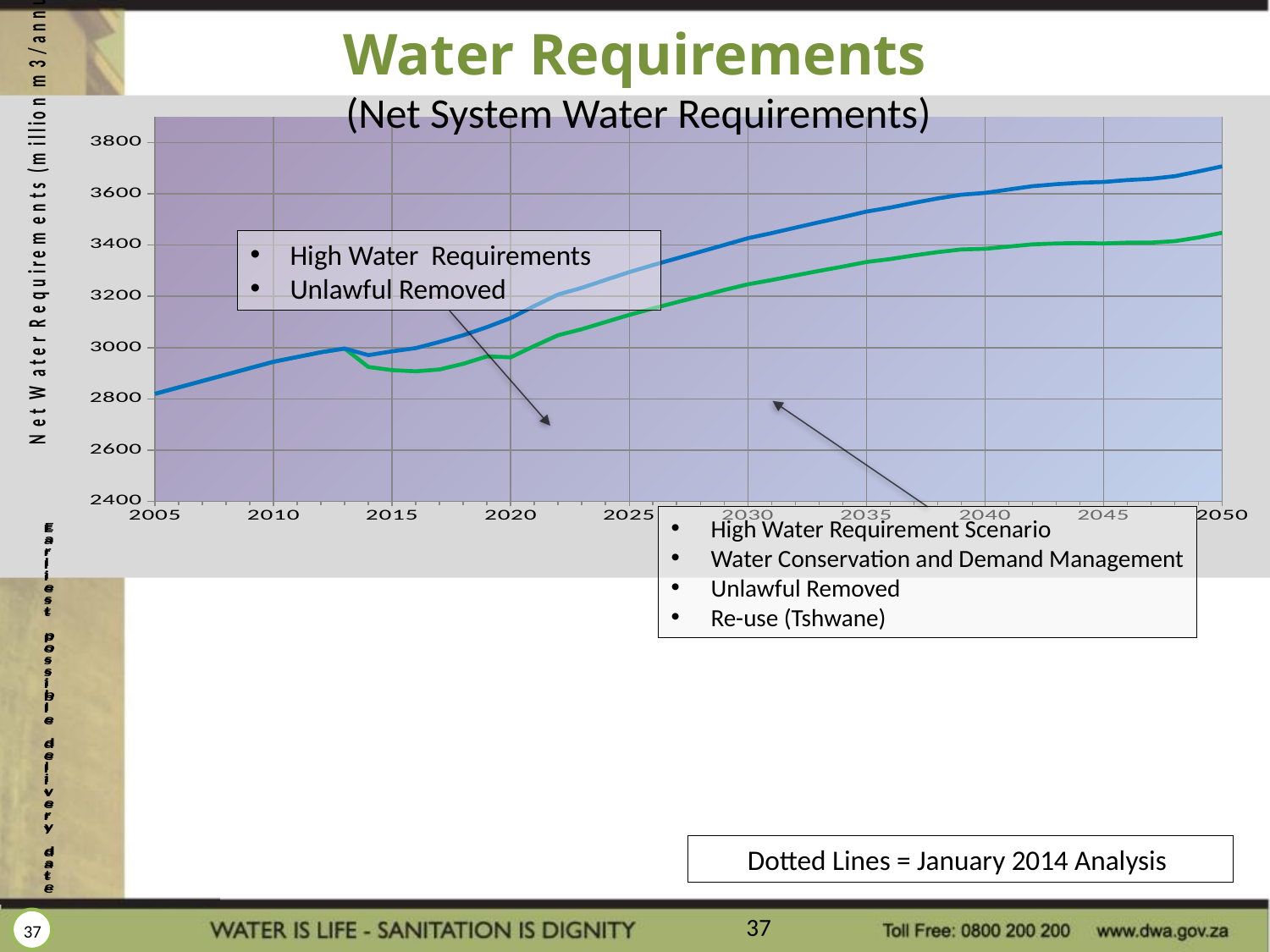
Is the value of the blue line in 2050 greater or less than 3600? greater What is the last year shown on the horizontal axis? 2050 In 2050, which line has the higher value, the blue line or the green line? blue line What is the lowest value shown on the vertical axis? 2400 Is the value of the green line in 2015 greater or less than 3000? less What kind of chart is shown on the slide? line chart Is the value of the blue line in 2020 greater or less than 3000? greater Do the values of the blue line generally rise or fall from 2005 to 2050? rise How many lines are plotted on the chart? 2